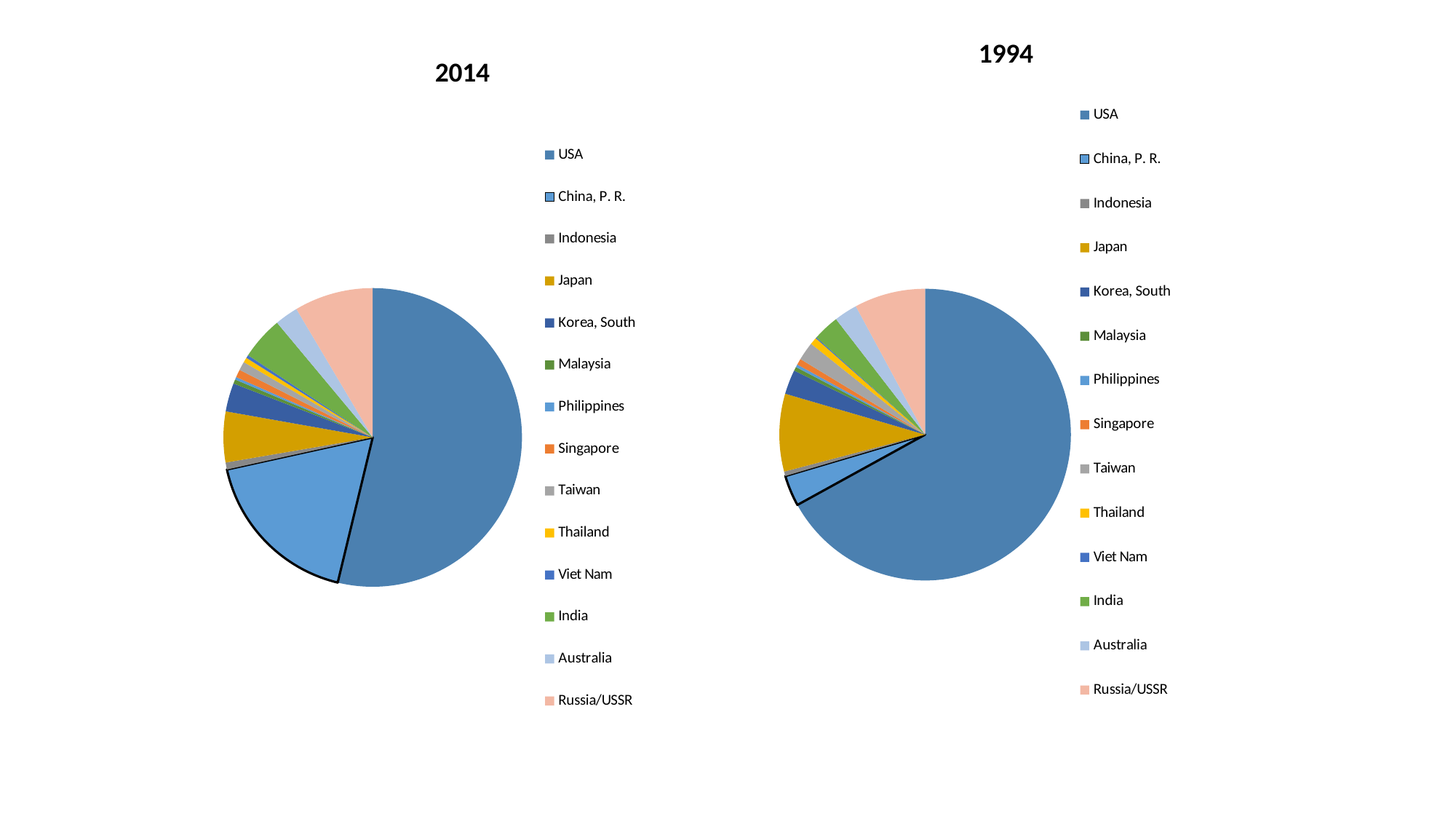
In the 2014 chart, which slice is larger, China, P. R. or Japan? China, P. R. What kind of chart is the chart titled 1994? pie chart In the 1994 chart, which slice is larger, USA or China, P. R.? USA In the 2014 chart, which category has the largest slice? USA What is the title of the pie chart on the left of the slide? 2014 In the 1994 chart, which slice is larger, Japan or China, P. R.? Japan In the 1994 chart, which category has the largest slice? USA How many categories does the legend of the 2014 chart list? 14 How many categories does the legend of the 1994 chart list? 14 What kind of chart is the chart titled 2014? pie chart What is the title of the pie chart on the right of the slide? 1994